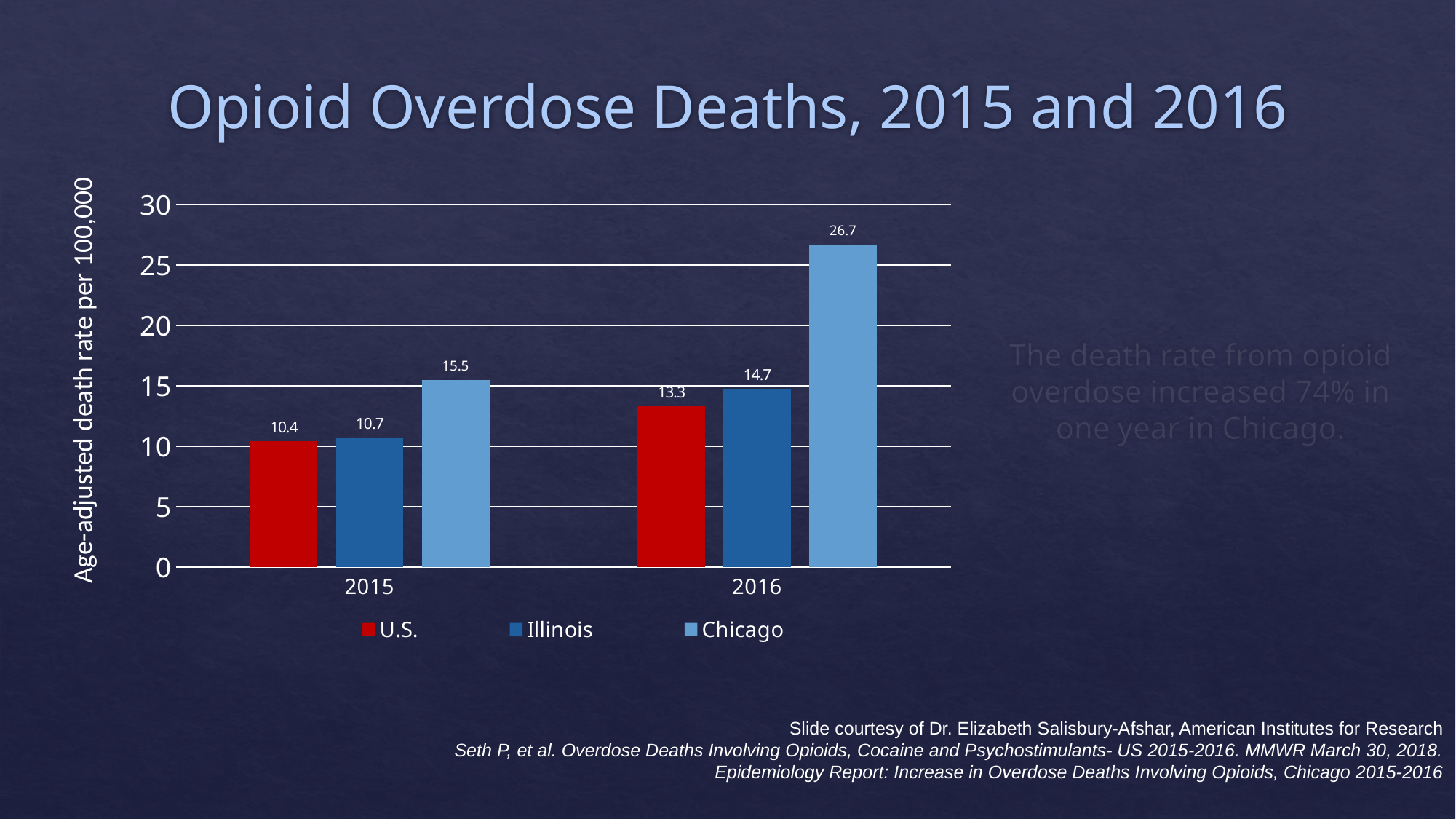
Which is larger: the Illinois rate in 2015 or the U.S. rate in 2016? U.S. rate in 2016 What is the age-adjusted death rate for the U.S. in 2015? 10.4 What is the age-adjusted death rate for Chicago in 2016? 26.7 What is the difference between Chicago's death rate in 2016 and in 2015? 11.2 How many years are shown on the x axis? 2 What is the age-adjusted death rate for Illinois in 2016? 14.7 Which series has the highest value in 2016? Chicago Which series has the lowest value in 2015? U.S. How many series does the legend list? 3 What kind of chart is shown on the slide? Bar chart Do the Chicago values rise or fall from 2015 to 2016? Rise Is the value for Chicago in 2016 greater or less than 25? greater